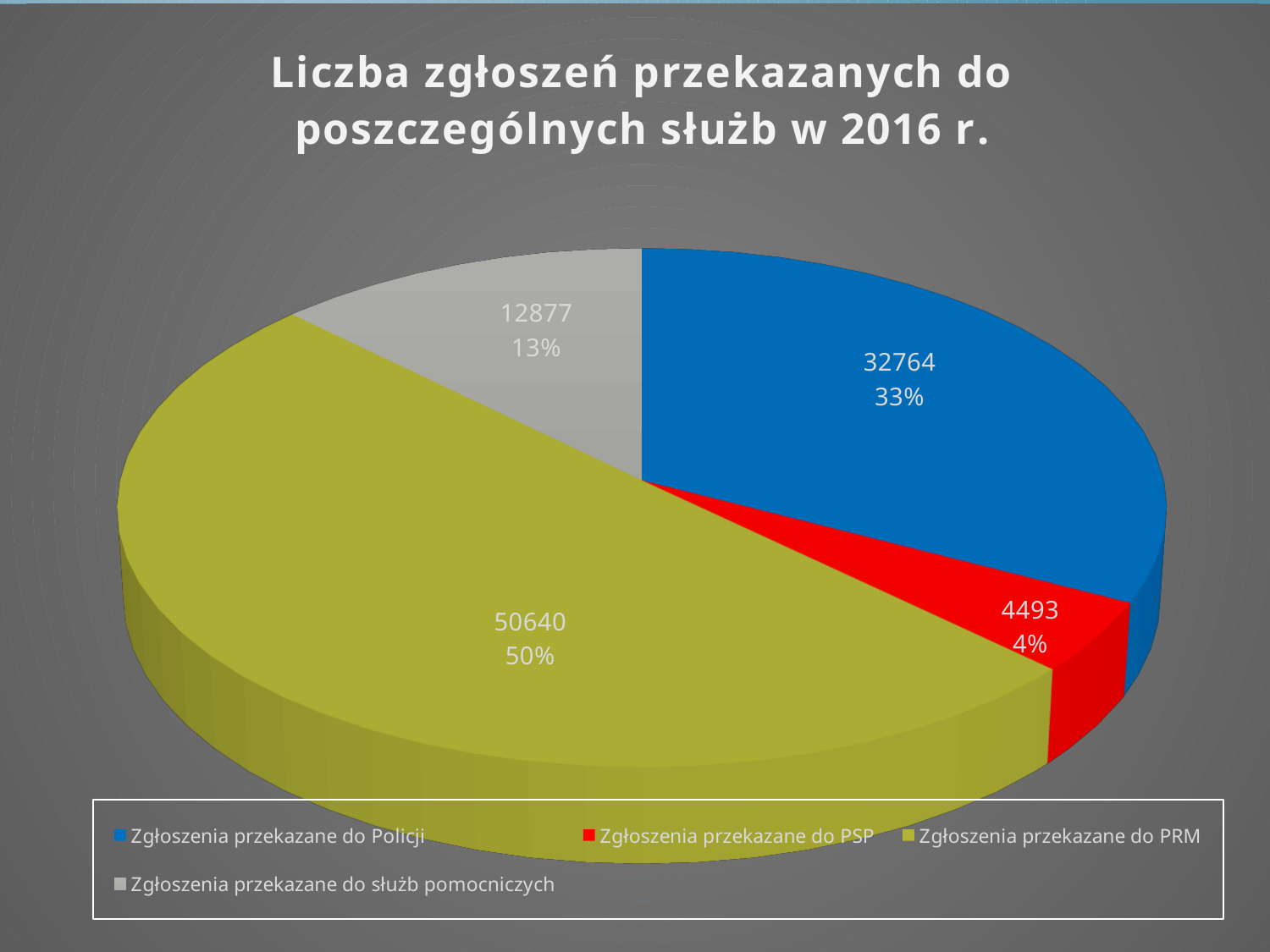
What is the value for Zgłoszenia przekazane do Policji? 32764 What share of the pie is Zgłoszenia przekazane do służb pomocniczych? 13% What is the difference between the values for Zgłoszenia przekazane do PRM and Zgłoszenia przekazane do Policji? 17876 How many slices does the pie chart have? 4 What is the title of the chart? Liczba zgłoszeń przekazanych do poszczególnych służb w 2016 r. Which category has the largest slice? Zgłoszenia przekazane do PRM What is the value for Zgłoszenia przekazane do PSP? 4493 What is the value for Zgłoszenia przekazane do PRM? 50640 How many entries does the legend list? 4 What kind of chart is shown on the slide? pie chart What is the value for Zgłoszenia przekazane do służb pomocniczych? 12877 Which category has the smallest slice? Zgłoszenia przekazane do PSP